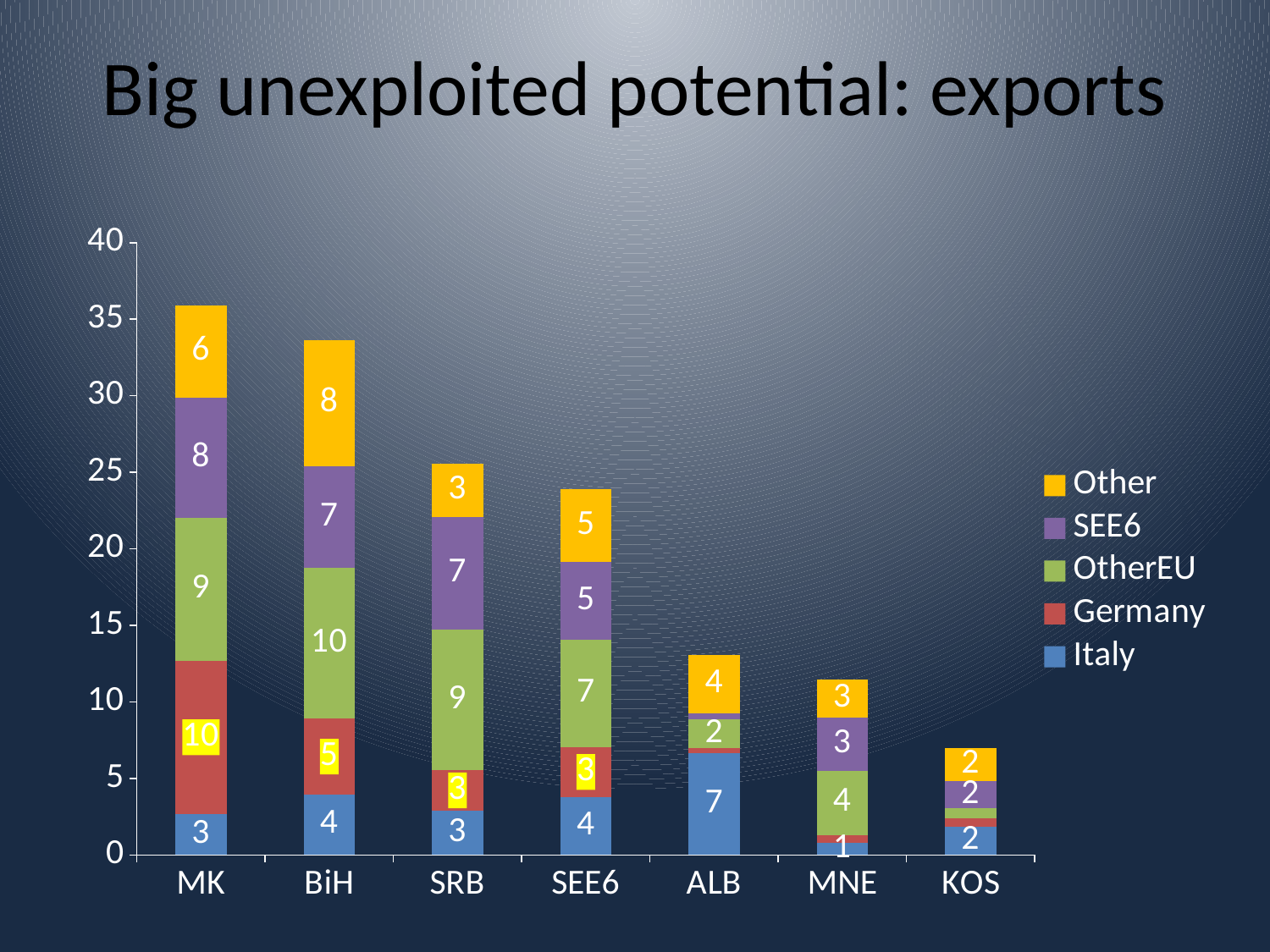
What is the title of the slide? Big unexploited potential: exports Which category has the shortest stacked bar? KOS What is the value of the OtherEU segment for BiH? 10 What is the value of the Germany segment for MK? 10 Which category has the tallest stacked bar? MK What is the value of the Italy segment for ALB? 7 How many categories are shown on the x axis? 7 Which is larger, the Other segment for BiH or the Other segment for MK? BiH How many series does the legend list? 5 What kind of chart is shown on the slide? Stacked bar chart What is the difference between the Germany segment for MK and the Germany segment for BiH? 5 Is the total height of the SRB bar greater or less than 20? greater